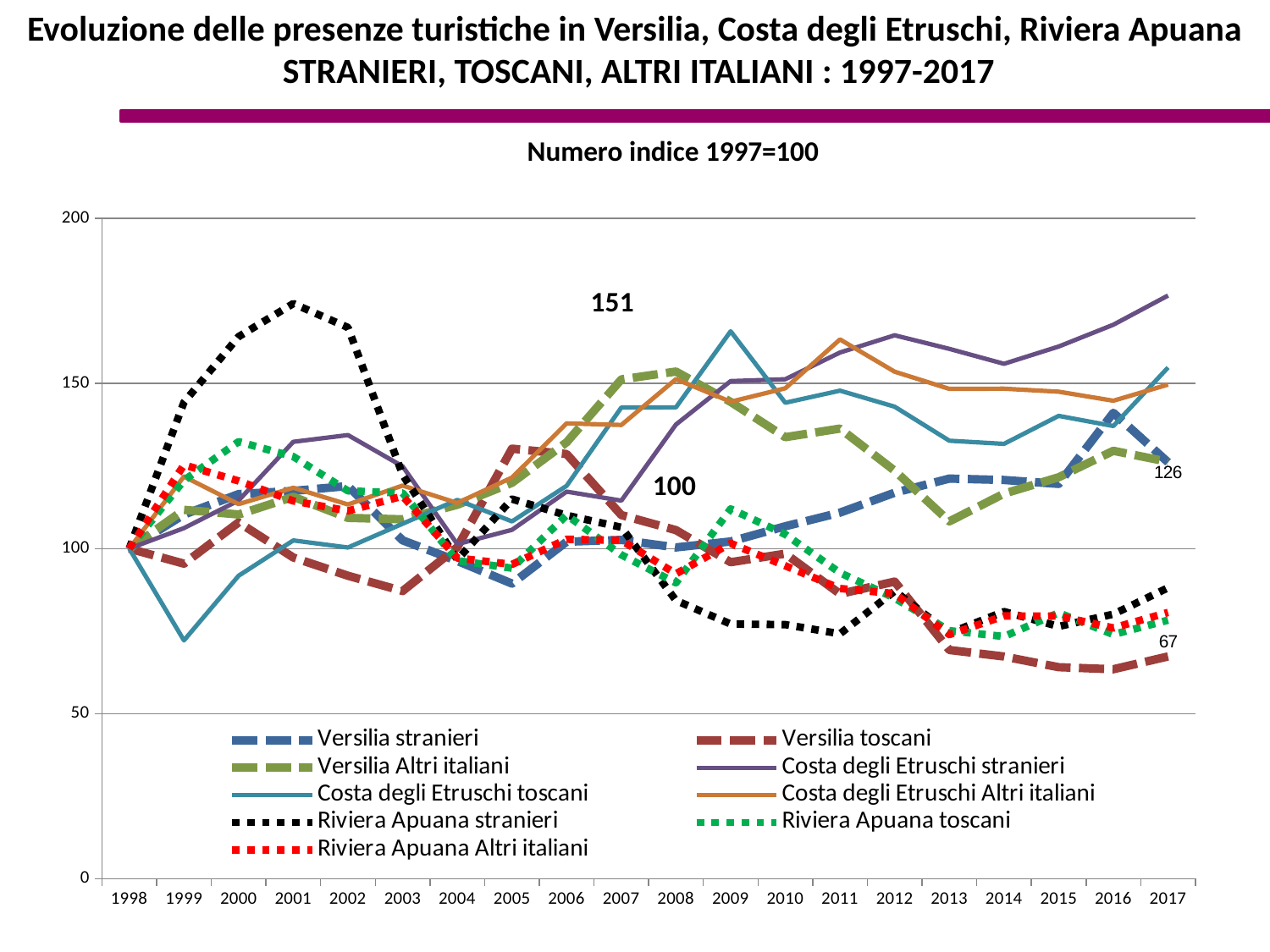
Does the Versilia toscani series rise or fall from 2009 to 2017? fall How many series does the legend list? 9 What base year and value does the index use, according to the chart subtitle? 1997=100 What is the difference between the 2017 values of Versilia stranieri and Versilia toscani? 59 Is the value for Costa degli Etruschi stranieri in 2017 greater or less than 150? greater Is the value for Costa degli Etruschi toscani in 1999 greater or less than 100? less What is the index value for Versilia toscani in 2017? 67 What kind of chart is shown on the slide? line chart How many years are shown along the x axis? 20 Which series has the lowest value in 2017? Versilia toscani What is the index value for Versilia stranieri in 2017? 126 Which series has the highest value in 2017? Costa degli Etruschi stranieri